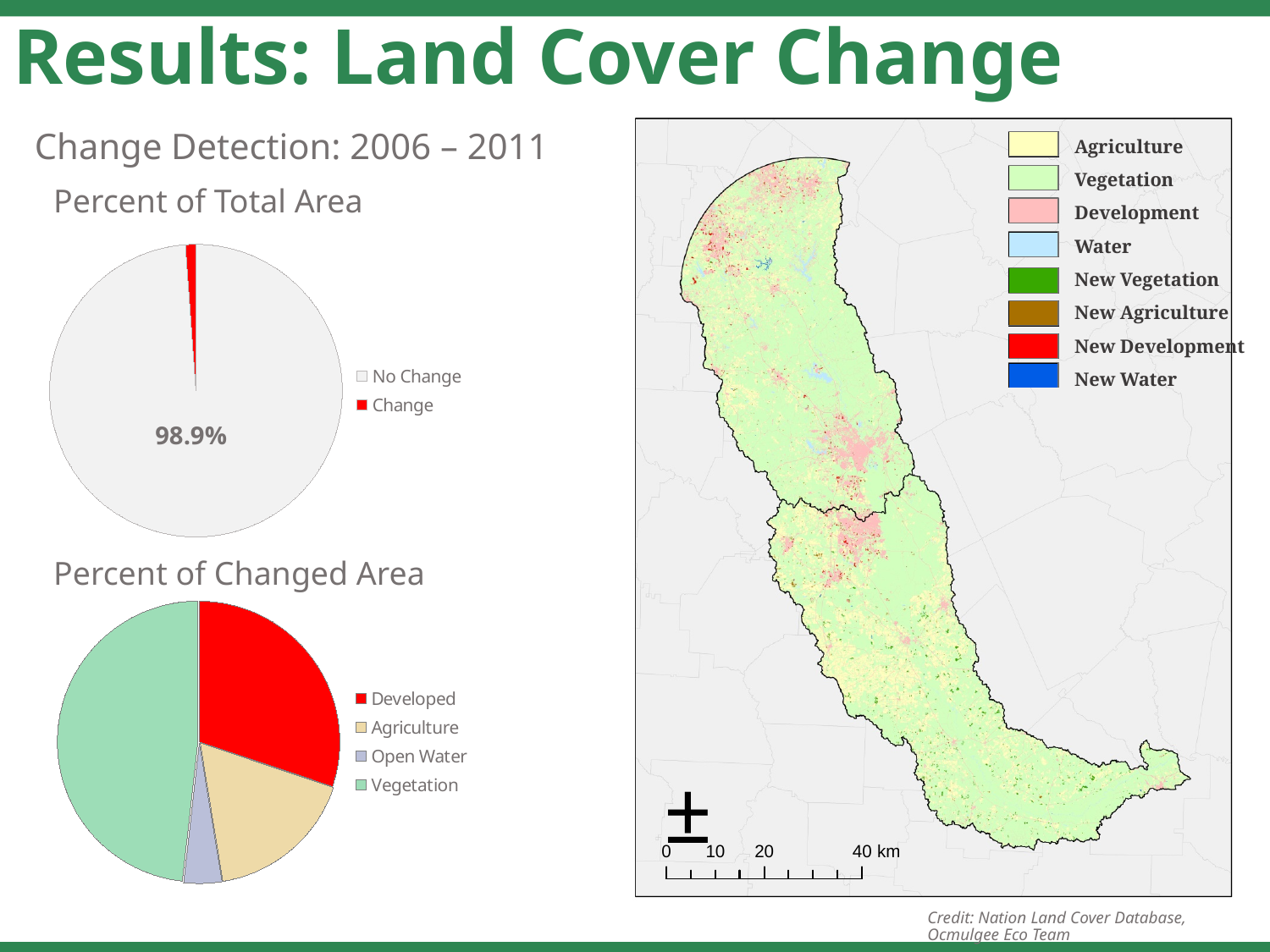
In the 'Percent of Changed Area' chart, which category has the smallest slice? Open Water In the 'Percent of Changed Area' chart, which slice is larger: Agriculture or Open Water? Agriculture How many categories does the legend of the 'Percent of Changed Area' chart list? 4 In the 'Percent of Changed Area' chart, which slice is larger: Developed or Agriculture? Developed In the 'Percent of Changed Area' chart, which category has the largest slice? Vegetation In the 'Percent of Changed Area' chart, what colour is the Developed slice? Red In the 'Percent of Total Area' chart, which category is the smallest? Change What kind of chart is the 'Percent of Total Area' chart? Pie chart In the 'Percent of Total Area' chart, what is the value shown for No Change? 98.9% What kind of chart is the 'Percent of Changed Area' chart? Pie chart How many categories does the legend of the 'Percent of Total Area' chart list? 2 In the 'Percent of Total Area' chart, which category is the largest? No Change